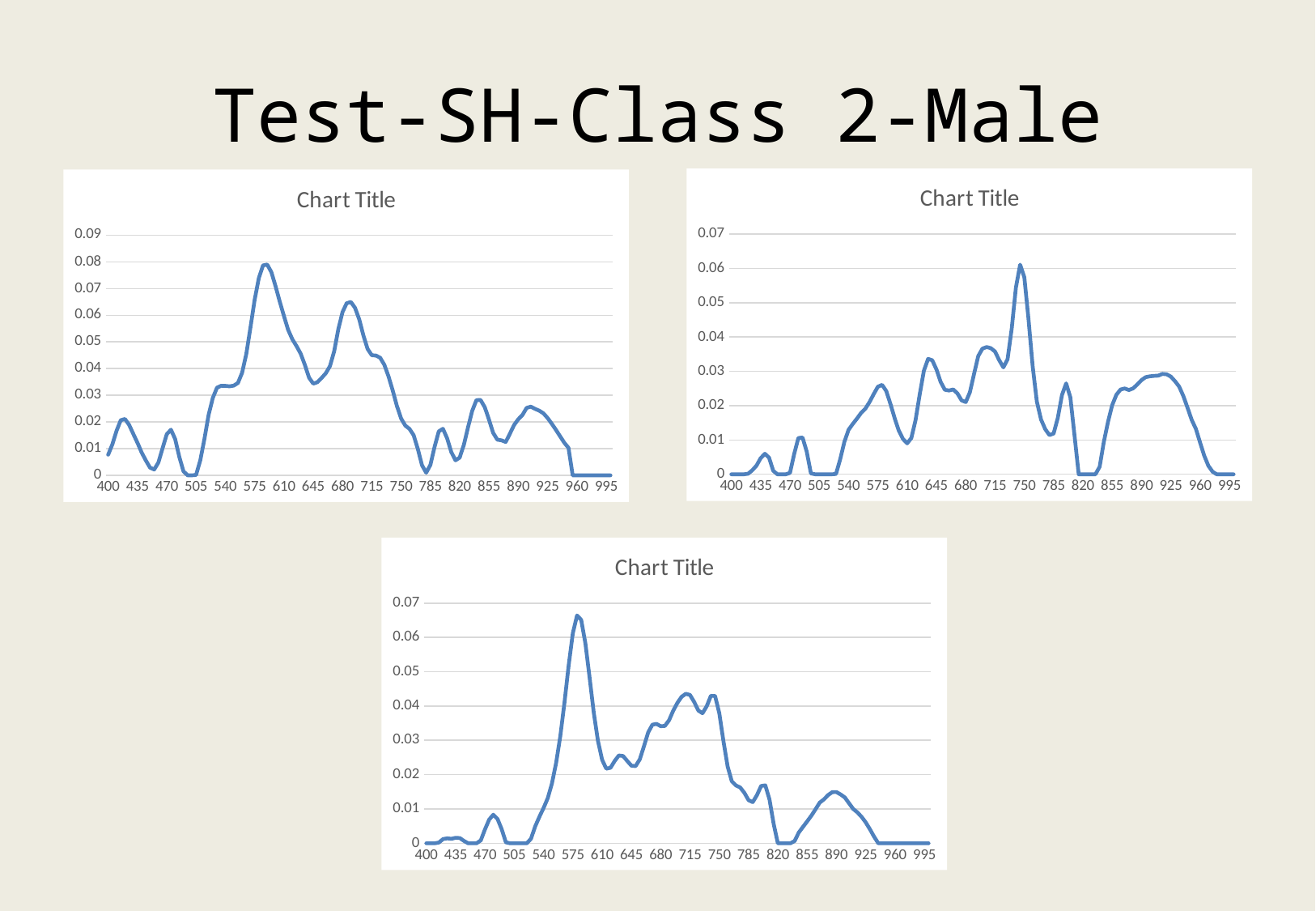
In the bottom chart, is the value at 575 greater or less than 0.05? greater In the top-left chart, is the value at 680 greater or less than 0.05? greater What is the highest value shown on the y axis of the top-left chart? 0.09 In the bottom chart, is the value at 400 greater or less than 0.01? less What kind of chart is the top-left chart? line chart What is the title of the bottom chart? Chart Title